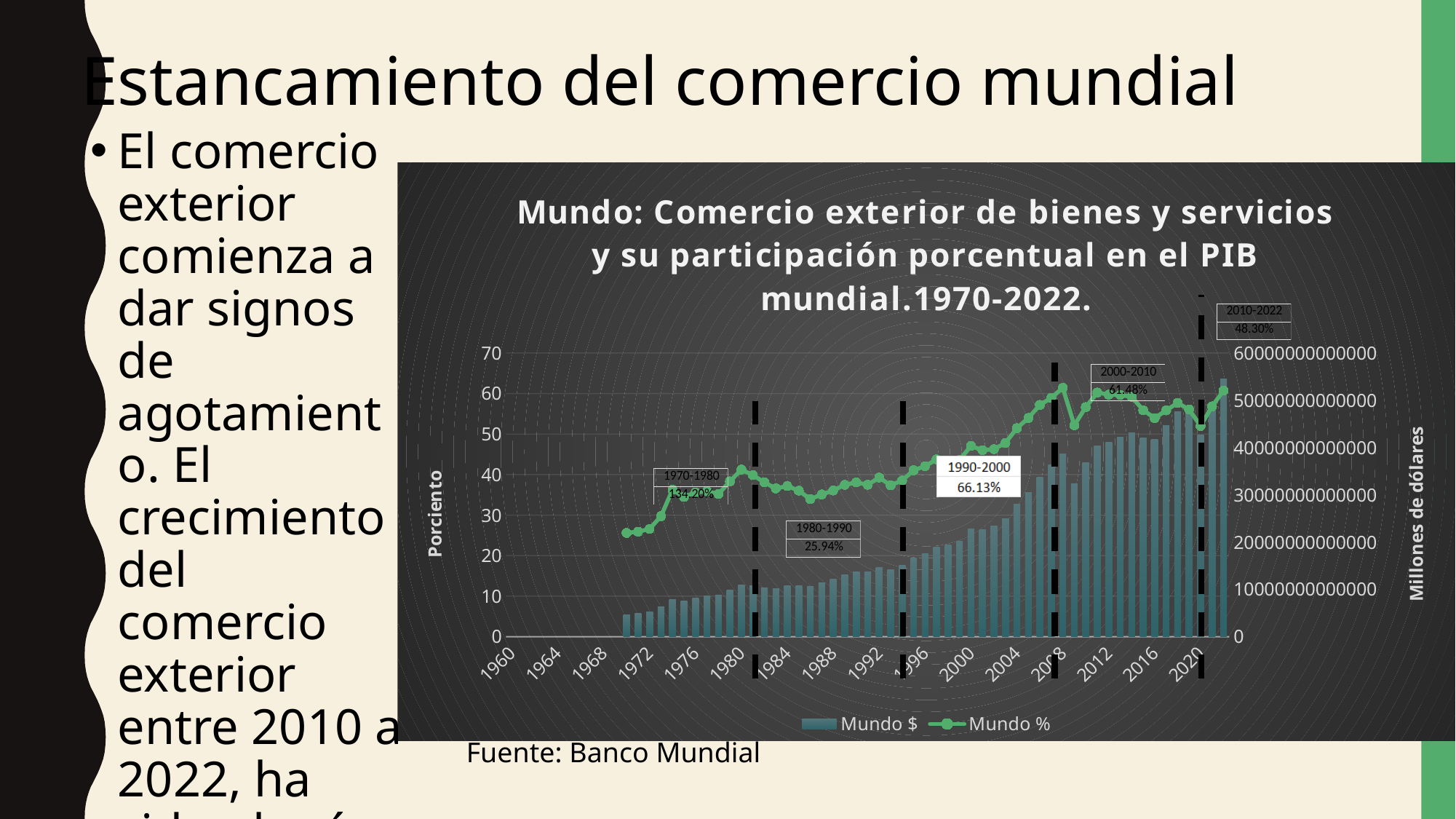
Is the Mundo % value for 1986 greater or less than 40? less What is the difference between the annotated growth figures for 1990-2000 and 2000-2010? 4.65 percentage points Which period annotation shows the highest growth figure? 1970-1980 What is the title of the chart? Mundo: Comercio exterior de bienes y servicios y su participación porcentual en el PIB mundial.1970-2022. What are the two series named in the legend? Mundo $ and Mundo % What growth figure is shown in the annotation for the 1970-1980 period? 134.20% What growth figure is shown in the annotation for the 1980-1990 period? 25.94% What kind of chart is shown on the slide? Combined bar and line chart How many series does the chart legend list? 2 Which period has the larger annotated growth figure, 1990-2000 or 2000-2010? 1990-2000 What growth figure is shown in the annotation for the 2010-2022 period? 48.30% Which period annotation shows the lowest growth figure? 1980-1990